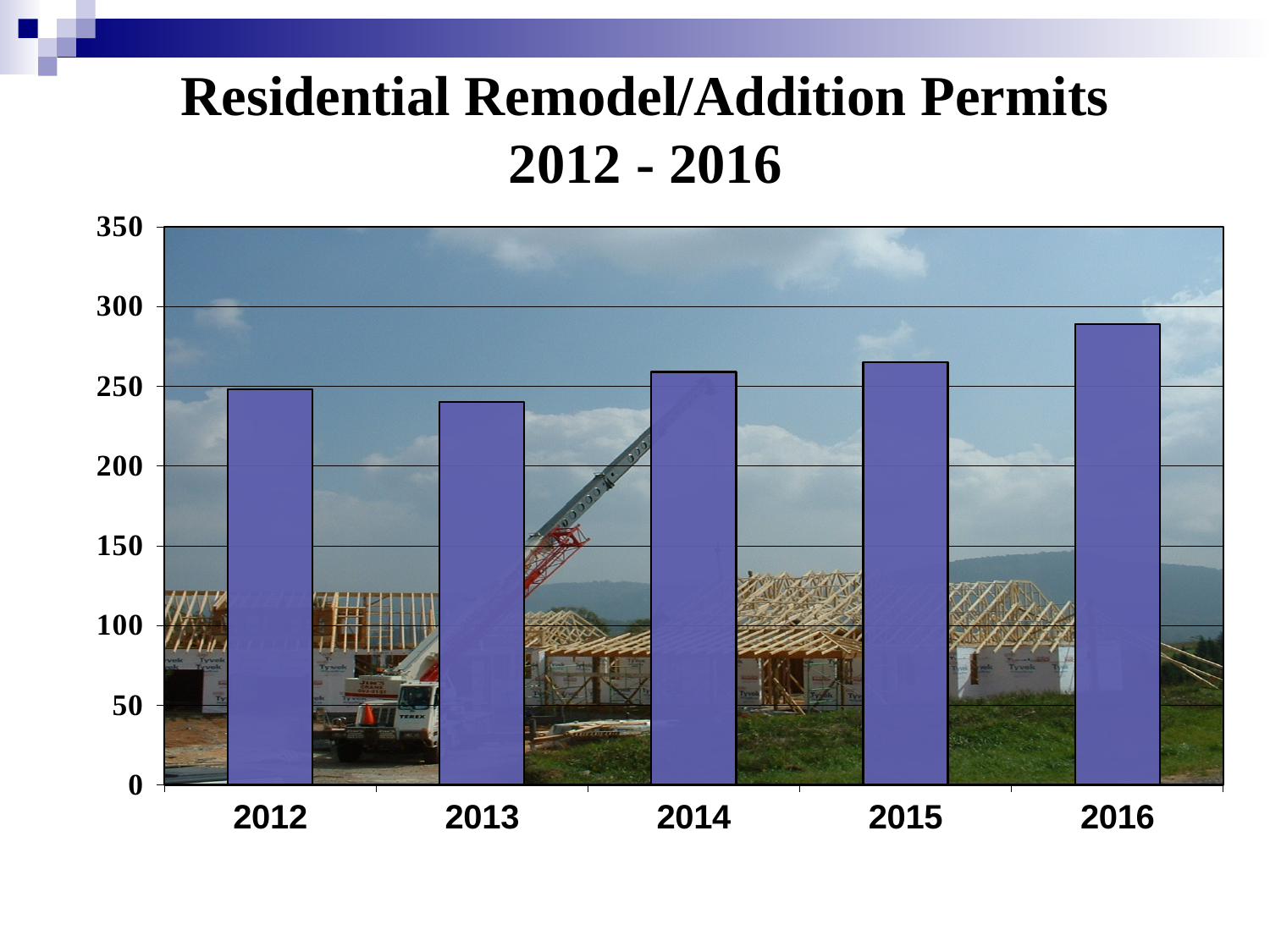
Is the value for 2016 greater or less than 300? less Which year has the highest number of residential remodel/addition permits? 2016 Is the value for 2015 greater or less than 250? greater Which is larger, the value for 2012 or the value for 2016? 2016 From 2013 to 2016, do the values rise or fall? rise Is the value for 2012 greater or less than 200? greater How many years are shown on the x axis of the chart? 5 What is the title of the chart on the slide? Residential Remodel/Addition Permits 2012 - 2016 Which is larger, the value for 2013 or the value for 2014? 2014 What kind of chart is shown on the slide? bar chart